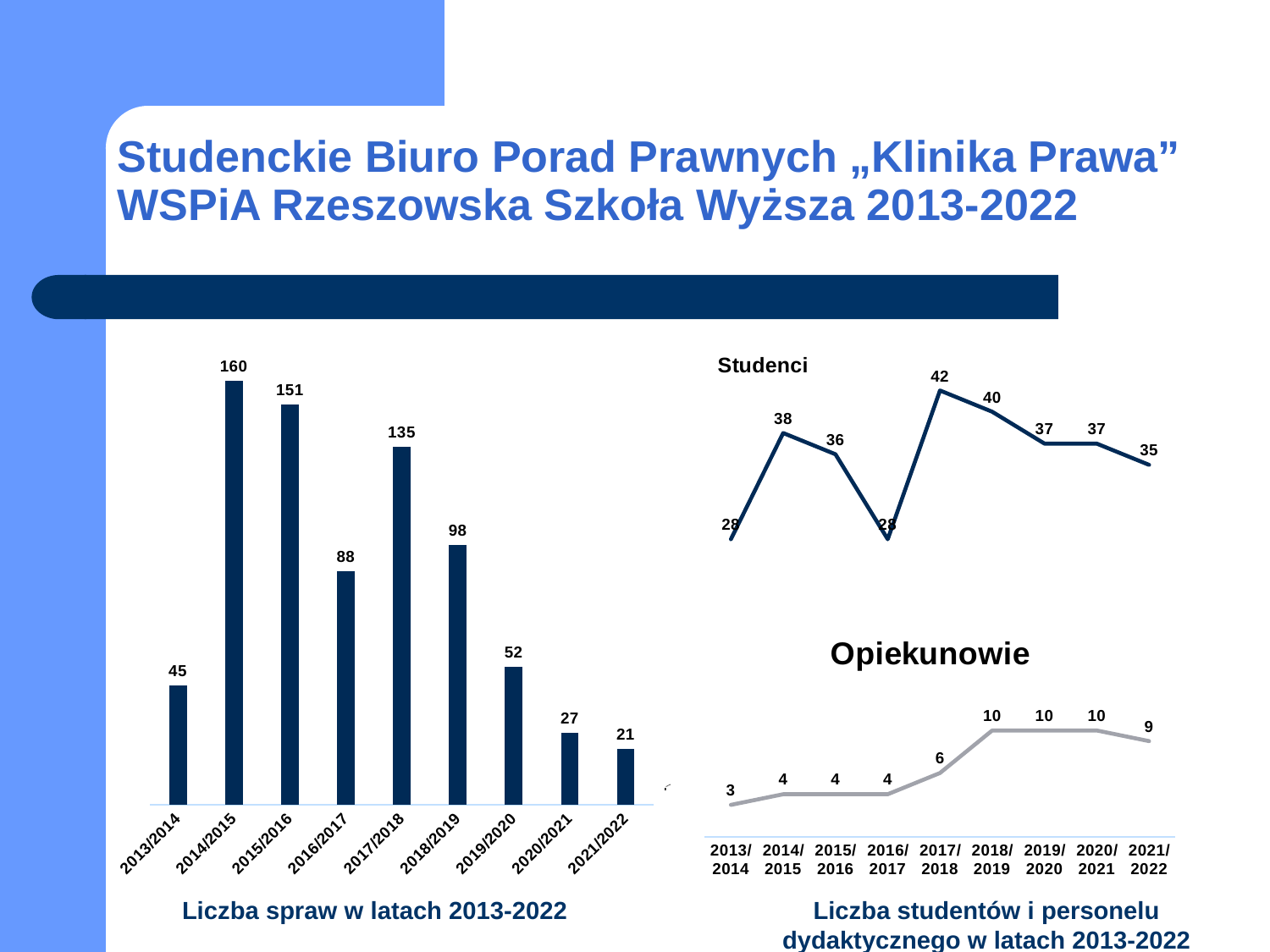
In the bar chart 'Liczba spraw w latach 2013-2022', which year has the highest value? 2014/2015 What kind of chart is the 'Opiekunowie' chart? line chart In the bar chart 'Liczba spraw w latach 2013-2022', what is the value for 2014/2015? 160 What kind of chart is 'Liczba spraw w latach 2013-2022'? bar chart In the bar chart 'Liczba spraw w latach 2013-2022', what is the difference between the values for 2017/2018 and 2018/2019? 37 In the bar chart 'Liczba spraw w latach 2013-2022', is the value for 2016/2017 larger than the value for 2019/2020? Yes, 2016/2017 In the bar chart 'Liczba spraw w latach 2013-2022', which year has the lowest value? 2021/2022 In the bar chart 'Liczba spraw w latach 2013-2022', how many years are shown on the x axis? 9 In the 'Studenci' line chart, what is the value for 2017/2018? 42 In the 'Opiekunowie' line chart, what is the value for 2013/2014? 3 In the 'Studenci' line chart, what is the value for the last year, 2021/2022? 35 In the 'Opiekunowie' line chart, what is the difference between the values for 2018/2019 and 2017/2018? 4